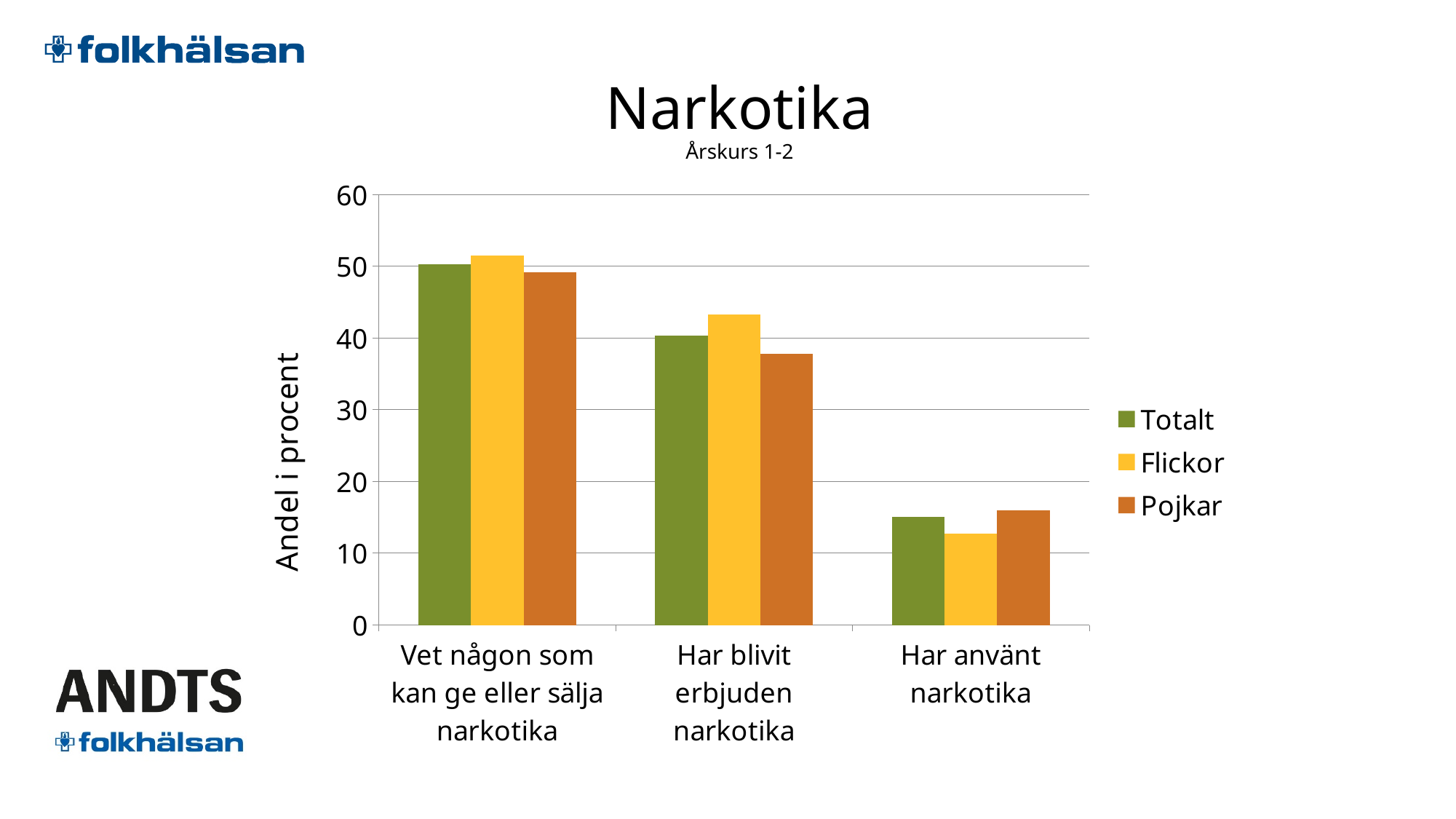
In 'Har blivit erbjuden narkotika', which is larger, Flickor or Pojkar? Flickor Is the value for Totalt in 'Vet någon som kan ge eller sälja narkotika' greater or less than 40? greater Which category has the highest value for Totalt? Vet någon som kan ge eller sälja narkotika How many series does the legend list? 3 How many categories are shown on the x axis? 3 What kind of chart is shown on the slide? bar chart Is the value for Pojkar in 'Har använt narkotika' greater or less than 20? less In 'Har använt narkotika', which is larger, Flickor or Pojkar? Pojkar Is the value for Pojkar in 'Har blivit erbjuden narkotika' greater or less than 40? less What is the label of the y axis? Andel i procent Which category has the lowest value for Flickor? Har använt narkotika